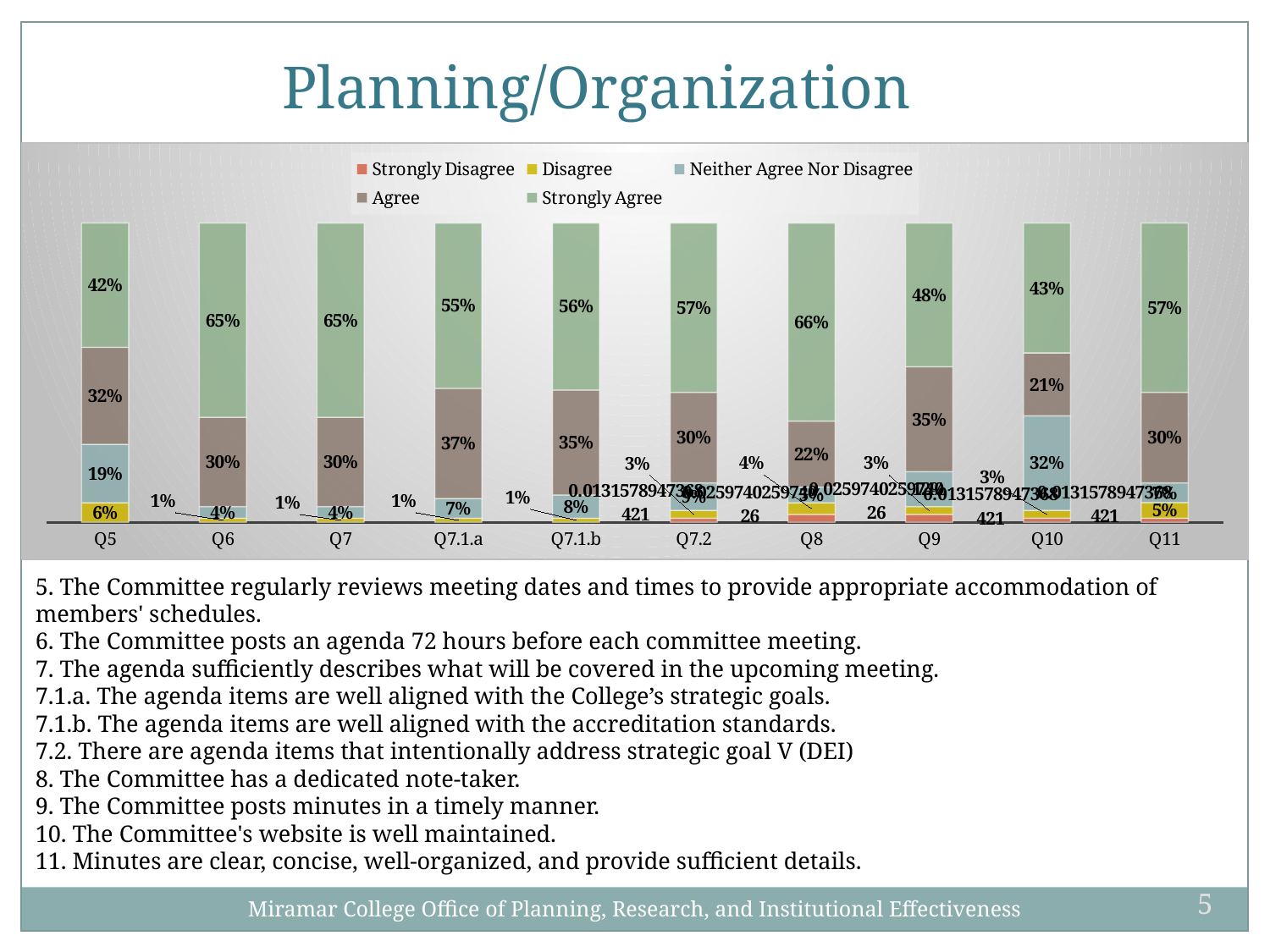
What is the Strongly Agree percentage for Q8? 66% Which has a larger Agree percentage, Q9 or Q10? Q9 What is the Disagree percentage for Q7.1.b? 1% What kind of chart is shown on the slide? Stacked bar chart How many series does the legend list? 5 What is the difference between the Strongly Agree percentages for Q6 and Q5? 23% Which series is shown in green in the legend? Strongly Agree What is the Agree percentage for Q7.1.a? 37% Which question has the lowest Strongly Agree percentage? Q5 How many question categories are shown along the x axis? 10 What is the Neither Agree Nor Disagree percentage for Q10? 32% Which question has the highest Strongly Agree percentage? Q8